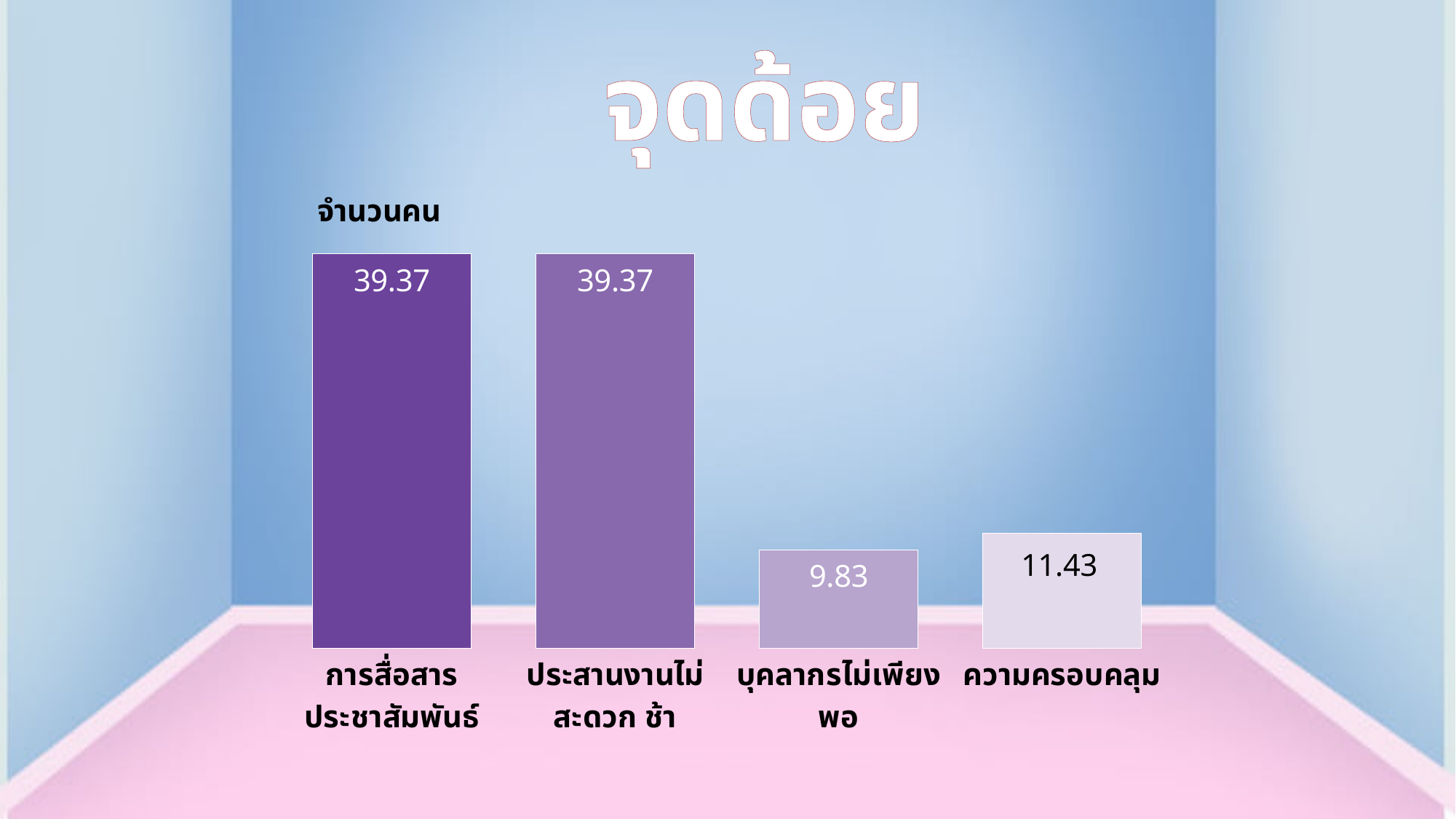
How many categories are shown in the chart? 4 What is the value for การสื่อสารประชาสัมพันธ์? 39.37 What is the value for ประสานงานไม่สะดวก ช้า? 39.37 What is the difference between the values for ความครอบคลุม and บุคลากรไม่เพียงพอ? 1.6 What is the value for ความครอบคลุม? 11.43 What is the title of the chart? จำนวนคน What is the difference between the values for การสื่อสารประชาสัมพันธ์ and ความครอบคลุม? 27.94 Which is larger, the value for ความครอบคลุม or the value for บุคลากรไม่เพียงพอ? ความครอบคลุม What is the value for บุคลากรไม่เพียงพอ? 9.83 Which category has the lowest value? บุคลากรไม่เพียงพอ Which is larger, the value for ประสานงานไม่สะดวก ช้า or the value for ความครอบคลุม? ประสานงานไม่สะดวก ช้า What kind of chart is shown on the slide? bar chart